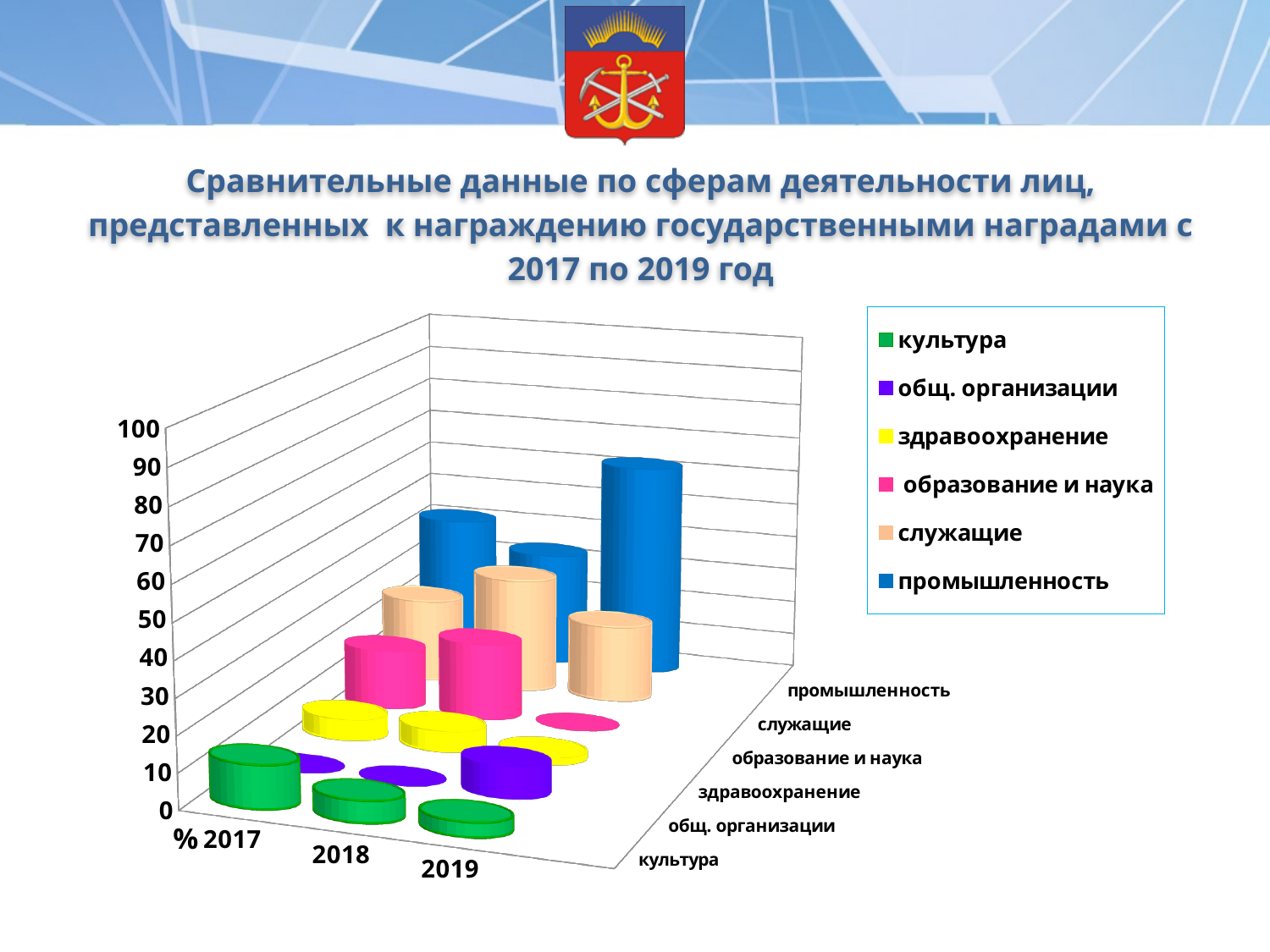
How many series does the legend list? 6 What colour represents промышленность in the legend? blue In which year is the value for промышленность the highest? 2019 Which is larger in 2017, промышленность or служащие? промышленность Is the value for культура in 2017 greater or less than 50? less Which series has the tallest bar in the chart? промышленность How many years are shown along the x axis of the chart? 3 Which years are shown on the x axis of the chart? 2017, 2018, 2019 Which is larger in 2019, промышленность or культура? промышленность What kind of chart is shown on the slide? bar chart Does the value for культура rise or fall from 2017 to 2019? fall Is the value for общ. организации in 2017 greater or less than 20? less